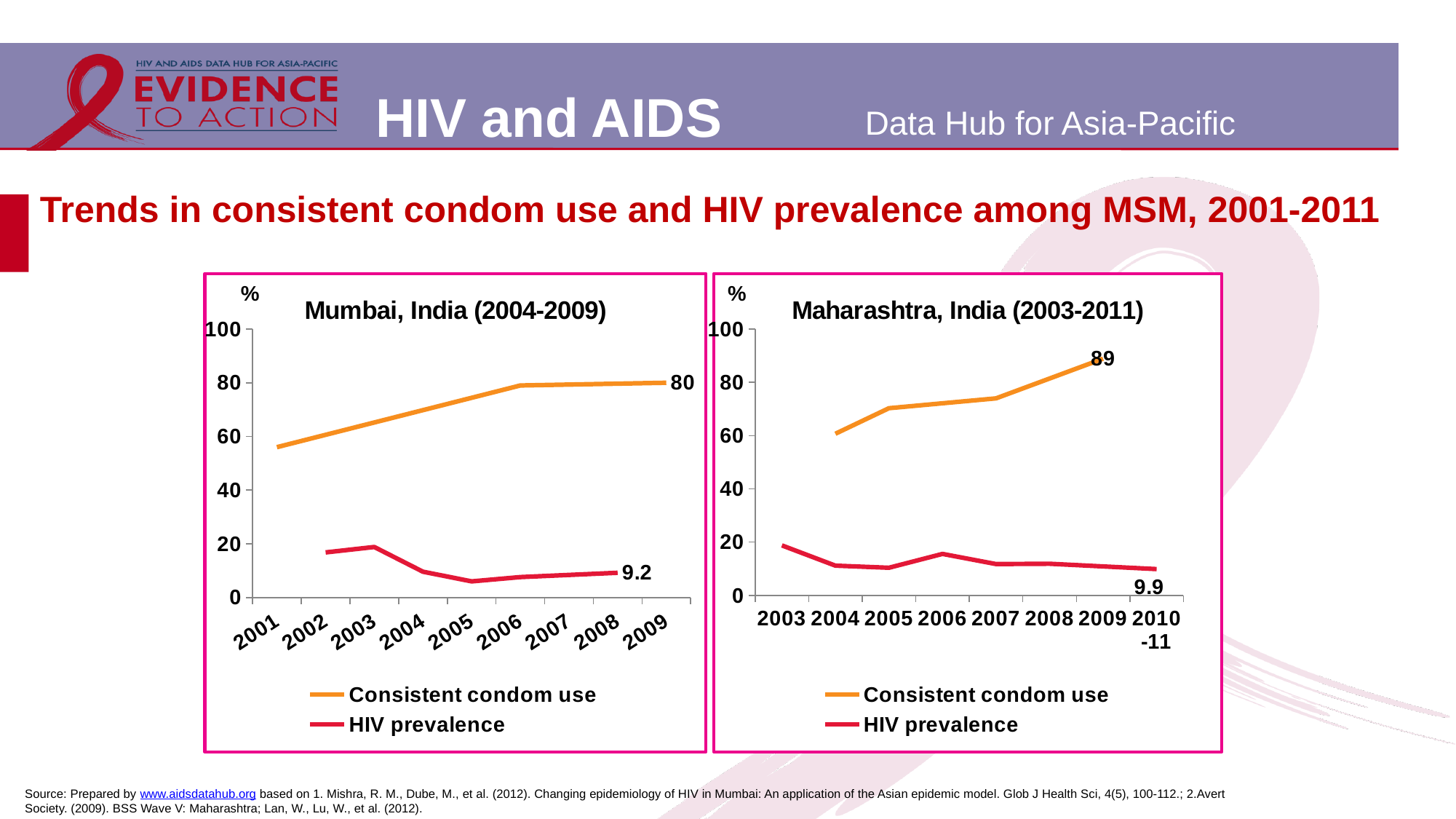
In the Mumbai, India (2004-2009) chart, what is the value of consistent condom use in 2009? 80 In the Mumbai, India (2004-2009) chart, what is the last labelled value of HIV prevalence? 9.2 In the Maharashtra, India (2003-2011) chart, what is the value of HIV prevalence in 2010-11? 9.9 In the Maharashtra, India (2003-2011) chart, is the value of consistent condom use in 2005 greater or less than 60? greater In the Mumbai, India (2004-2009) chart, does consistent condom use rise or fall over the years shown? rise Which is larger: consistent condom use in 2009 in the Mumbai chart or in the Maharashtra chart? Maharashtra What type of chart is the Mumbai, India (2004-2009) chart? line chart In the Maharashtra, India (2003-2011) chart, what is the value of consistent condom use in 2009? 89 How many series does the legend of the Maharashtra, India (2003-2011) chart list? 2 What is the difference between the 2009 consistent condom use value in the Maharashtra chart (89) and in the Mumbai chart (80)? 9